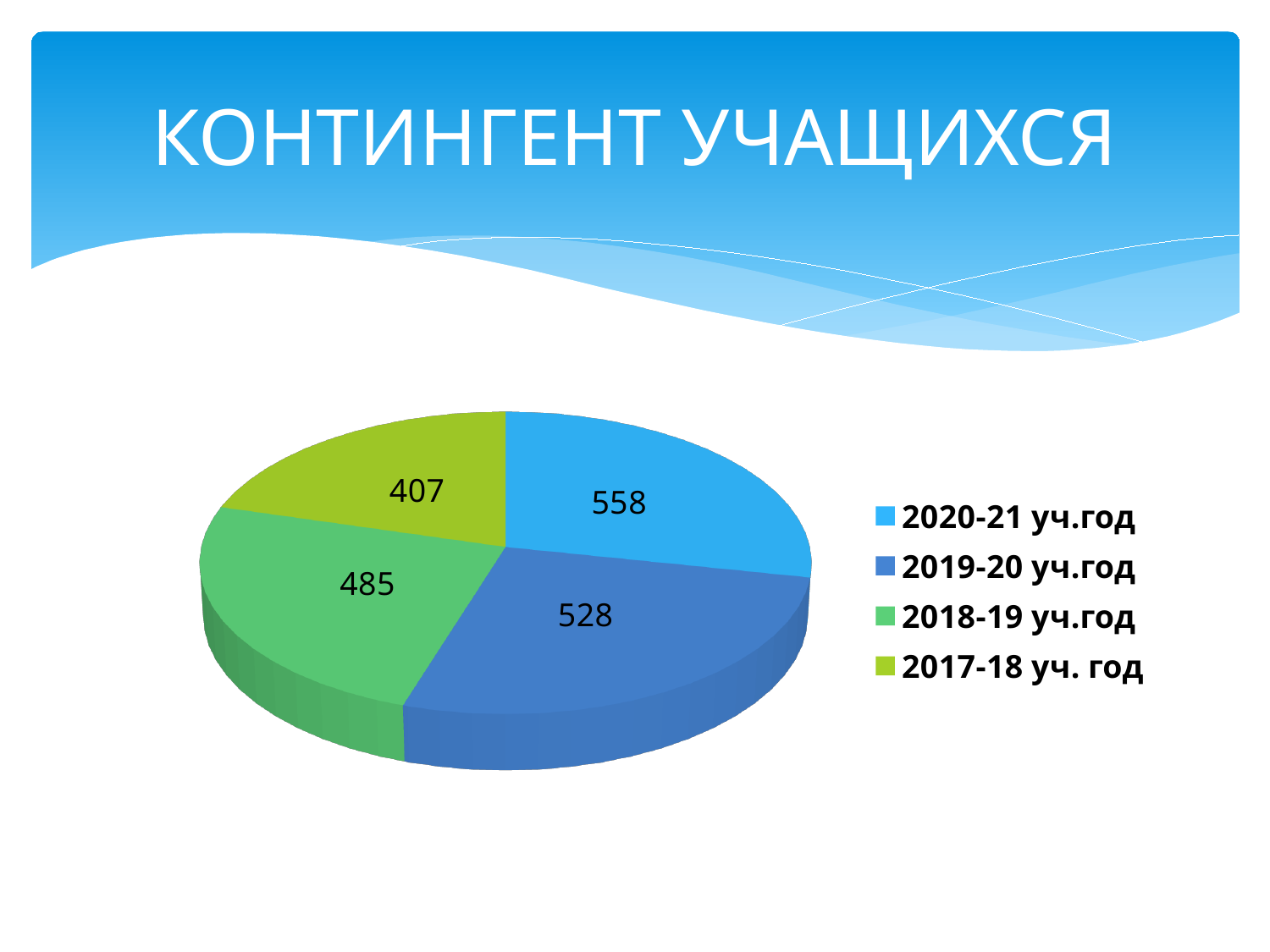
What is the title of the slide? КОНТИНГЕНТ УЧАЩИХСЯ What is the difference between the values for 2020-21 уч.год and 2017-18 уч. год? 151 Which academic year has the smallest slice? 2017-18 уч. год What type of chart is shown on the slide? pie chart Which academic year has the largest slice? 2020-21 уч.год How many slices does the pie chart have? 4 Which is larger, the value for 2019-20 уч.год or 2018-19 уч.год? 2019-20 уч.год What is the value for 2018-19 уч.год? 485 What is the value for 2020-21 уч.год? 558 What is the value for 2017-18 уч. год? 407 What is the value for 2019-20 уч.год? 528 What is the difference between the values for 2019-20 уч.год and 2018-19 уч.год? 43